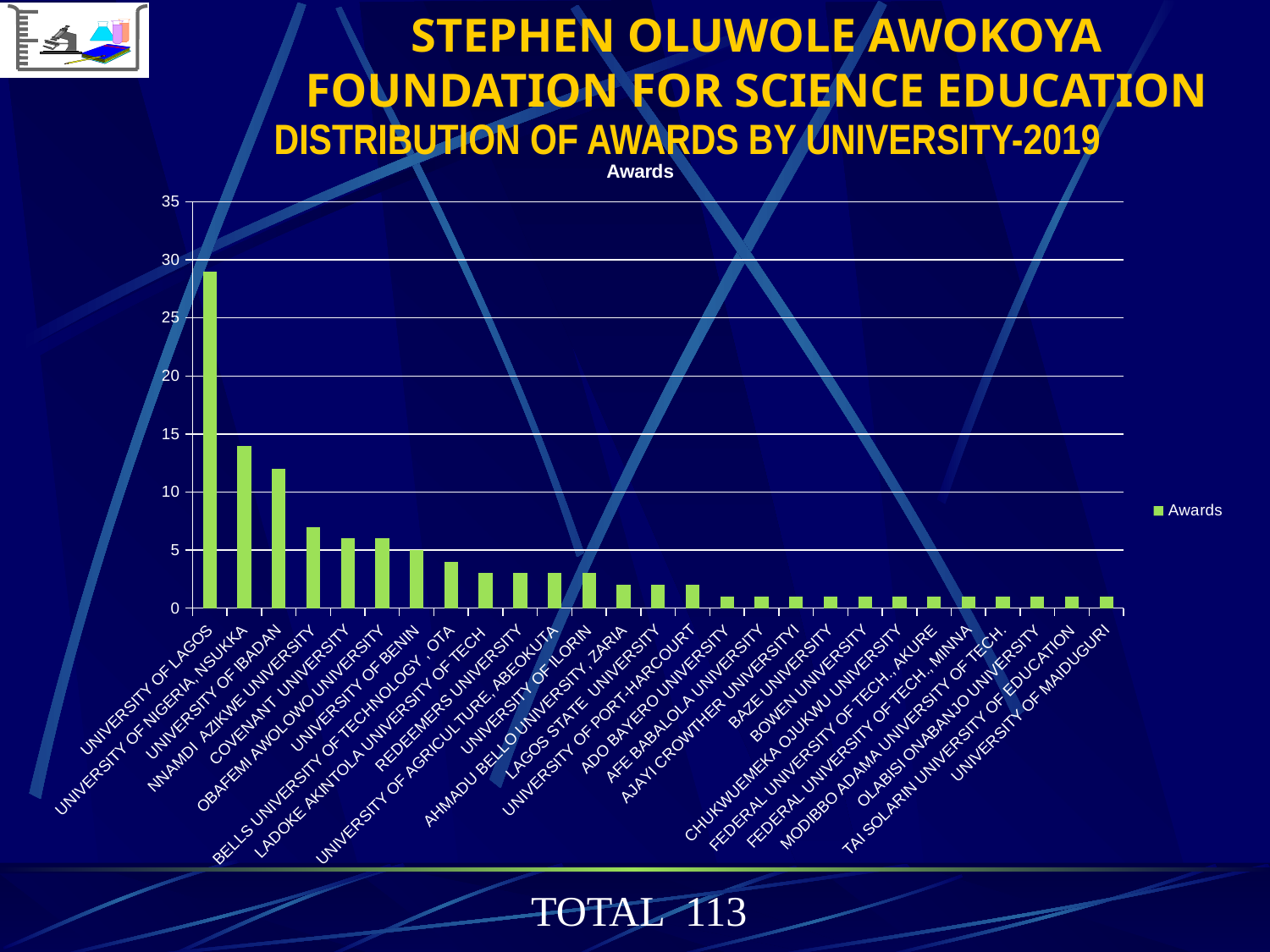
How many universities are shown on the x axis? 27 What is the title shown above the chart's plot area? Awards Do the values rise or fall moving from left to right along the x axis? fall Which university has the highest number of awards? University of Lagos Is the value for Nnamdi Azikwe University greater or less than 10? less Which has more awards, University of Ibadan or Covenant University? University of Ibadan Which has more awards, University of Lagos or University of Nigeria, Nsukka? University of Lagos How many series does the legend list? 1 What kind of chart is shown on the slide? bar chart Is the value for University of Nigeria, Nsukka greater or less than 10? greater Is the value for University of Maiduguri greater or less than 5? less